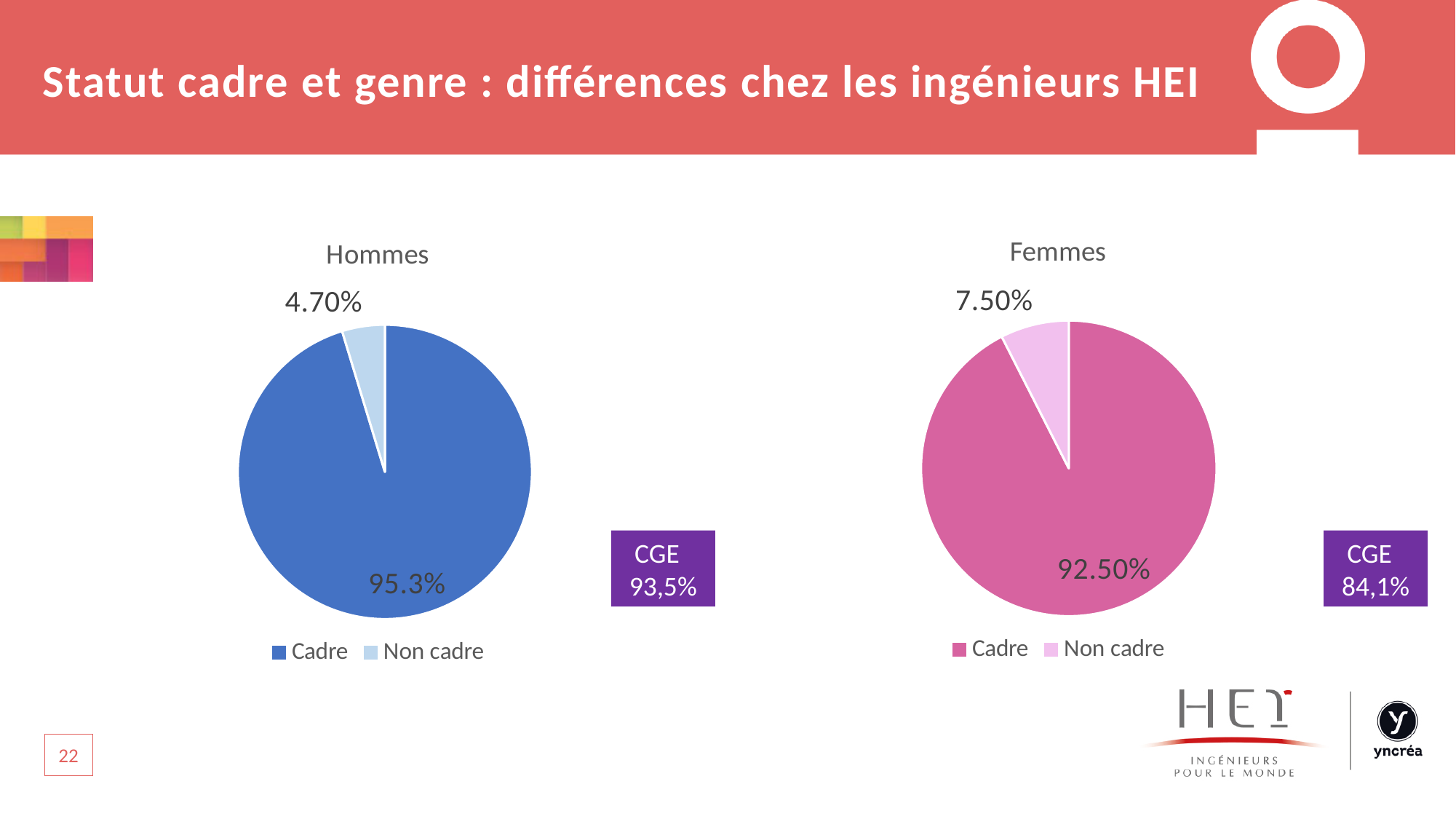
What type of chart is the Hommes chart? Pie chart In the Femmes chart, what share of the pie is Cadre? 92.50% In the Hommes chart, what share of the pie is Non cadre? 4.70% In the Femmes chart, which slice is the smallest? Non cadre In the Femmes chart, what share of the pie is Non cadre? 7.50% What is the difference between the Cadre share in the Hommes chart and the Cadre share in the Femmes chart? 2.8% How many entries does the legend of the Hommes chart list? 2 Is the Non cadre share larger in the Hommes chart or the Femmes chart? Femmes How many slices does the Femmes pie chart have? 2 What is the title of the chart on the right of the slide? Femmes In the Hommes chart, which slice is the largest? Cadre In the Hommes chart, what share of the pie is Cadre? 95.3%